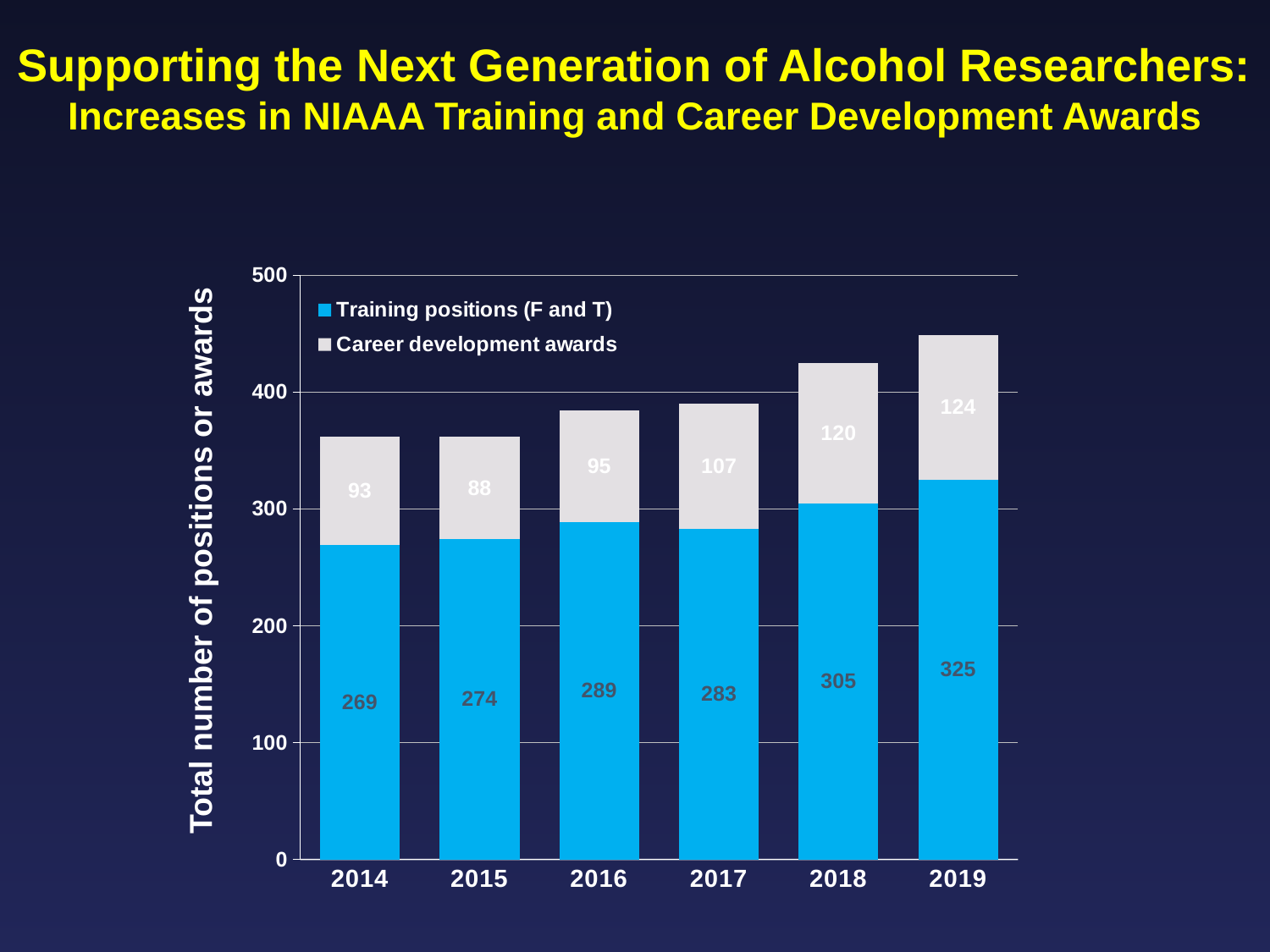
What is the total of the stacked bar for 2014? 362 What is the total of the stacked bar for 2018? 425 What kind of chart is shown on the slide? Stacked bar chart How many career development awards were there in 2017? 107 Which year has the highest number of training positions (F and T)? 2019 Do the career development awards generally rise or fall from 2015 to 2019? Rise Which is larger: career development awards in 2016 or in 2015? 2016 What is the difference in training positions (F and T) between 2019 and 2014? 56 How many years are shown on the x axis? 6 Which year has the lowest number of career development awards? 2015 How many series does the legend list? 2 What is the number of training positions (F and T) in 2019? 325